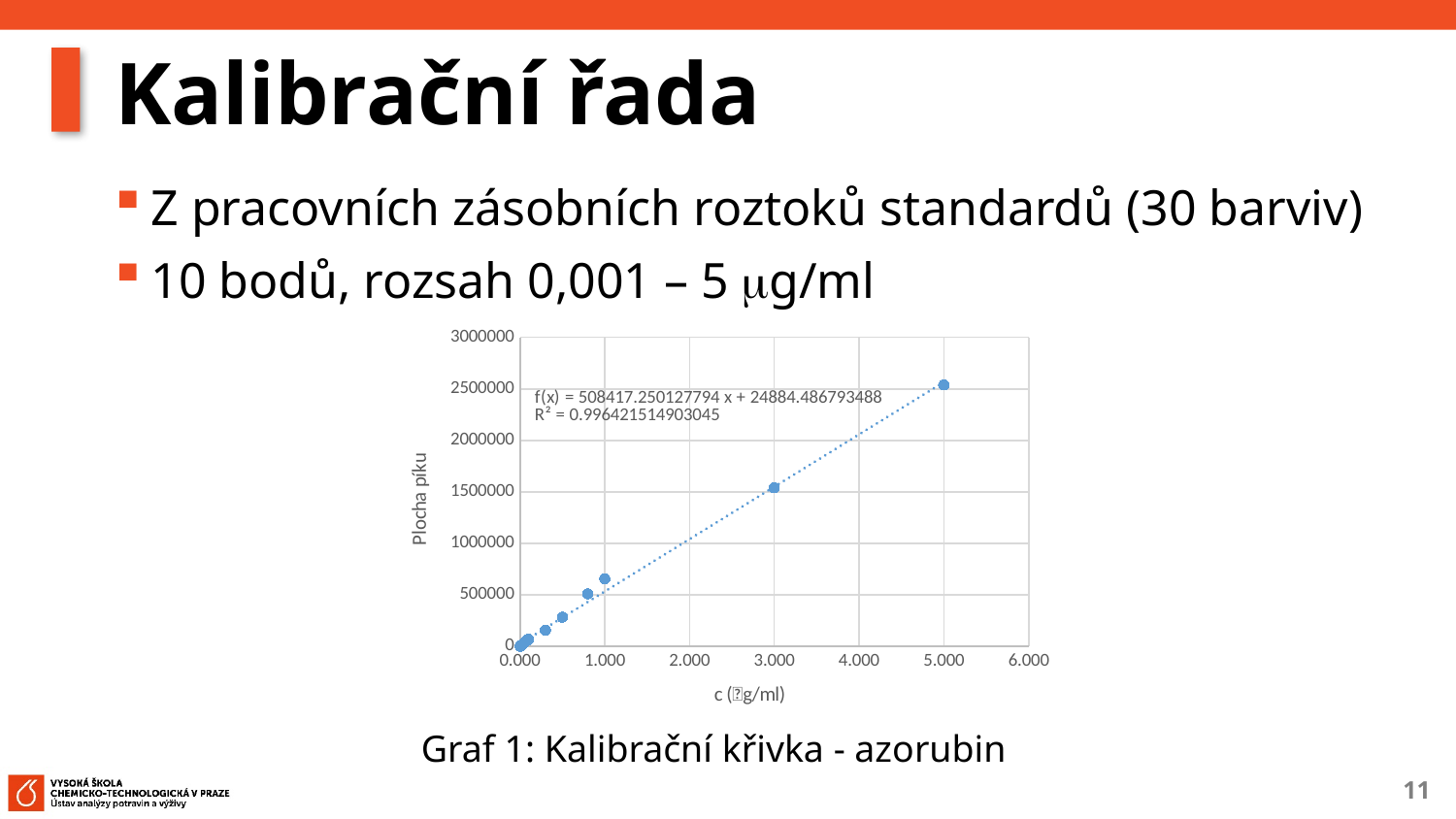
Is the peak area for the point at c = 3.000 greater or less than 2000000? less What is the title of the chart (Graf 1)? Kalibrační křivka - azorubin Is the peak area for the point at c = 5.000 greater or less than 2000000? greater Is the peak area for the point at c = 1.000 greater or less than 1000000? less What is the label of the y axis of the chart? Plocha píku At which concentration on the x axis is the highest plotted peak area? 5.000 What is the trendline equation shown on the chart? f(x) = 508417.250127794 x + 24884.486793488 What is the R² value of the trendline shown on the chart? 0.996421514903045 Do the plotted values rise or fall as the concentration c increases along the x axis? rise Which point has the larger peak area, the one at c = 3.000 or the one at c = 5.000? c = 5.000 What kind of chart is shown on the slide? scatter chart